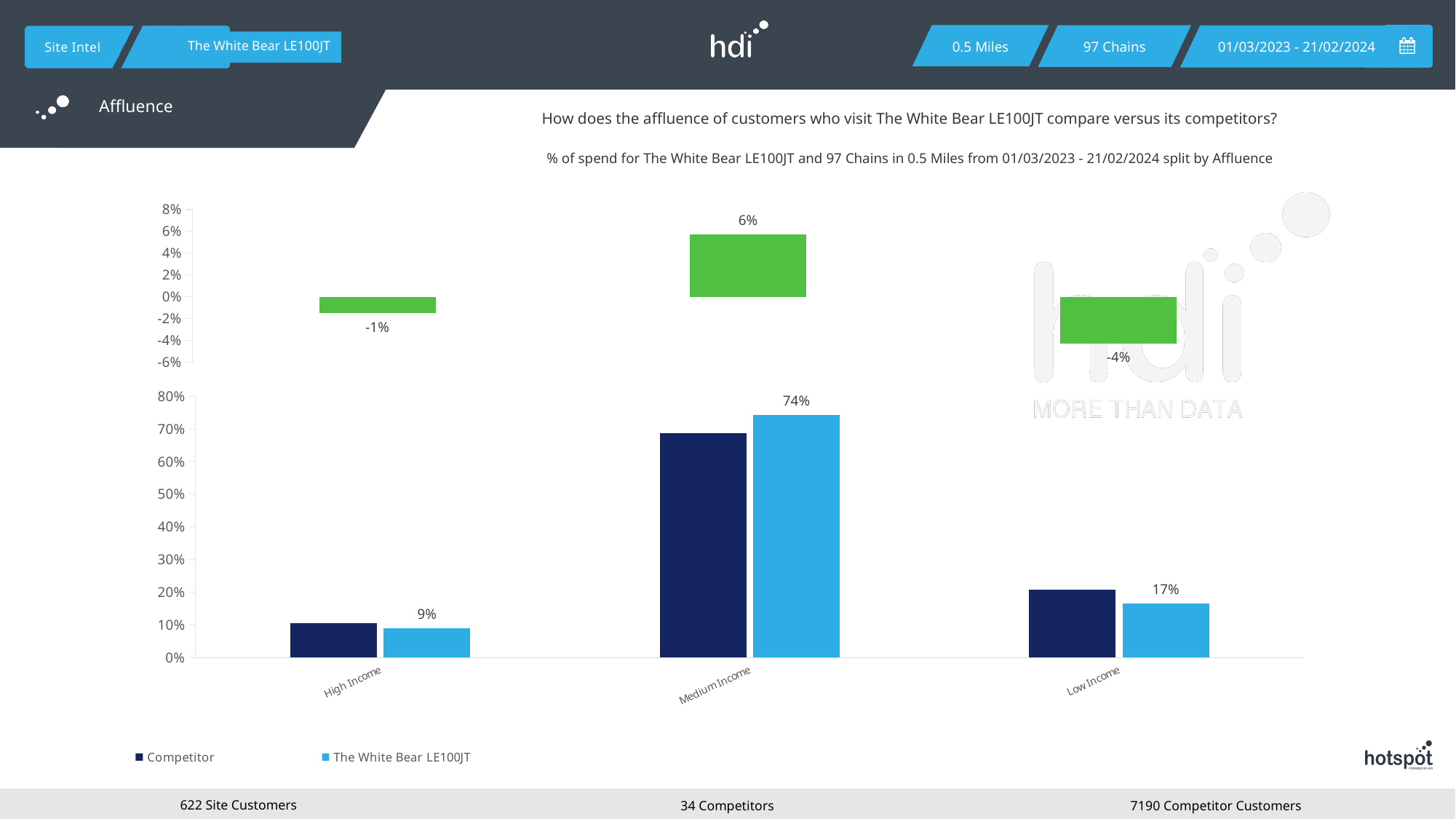
In the bottom chart, what is the value for The White Bear LE100JT in the High Income category? 9% How many series does the legend of the bottom chart list? 2 In the bottom chart, what is the value for The White Bear LE100JT in the Low Income category? 17% In the top chart, what is the value shown for Medium Income? 6% In the bottom chart, is the Competitor value for Low Income greater or less than 30%? less In the bottom chart, is the Competitor value for Medium Income greater or less than 60%? greater In the bottom chart, which is larger for Medium Income: Competitor or The White Bear LE100JT? The White Bear LE100JT In the top chart, what is the value shown for Low Income? -4% In the bottom chart, which category has the highest value for The White Bear LE100JT? Medium Income In the top chart, which category has the lowest value? Low Income In the bottom chart, what is the difference between The White Bear LE100JT's Medium Income value and its Low Income value? 57% In the bottom chart, what is the value for The White Bear LE100JT in the Medium Income category? 74%